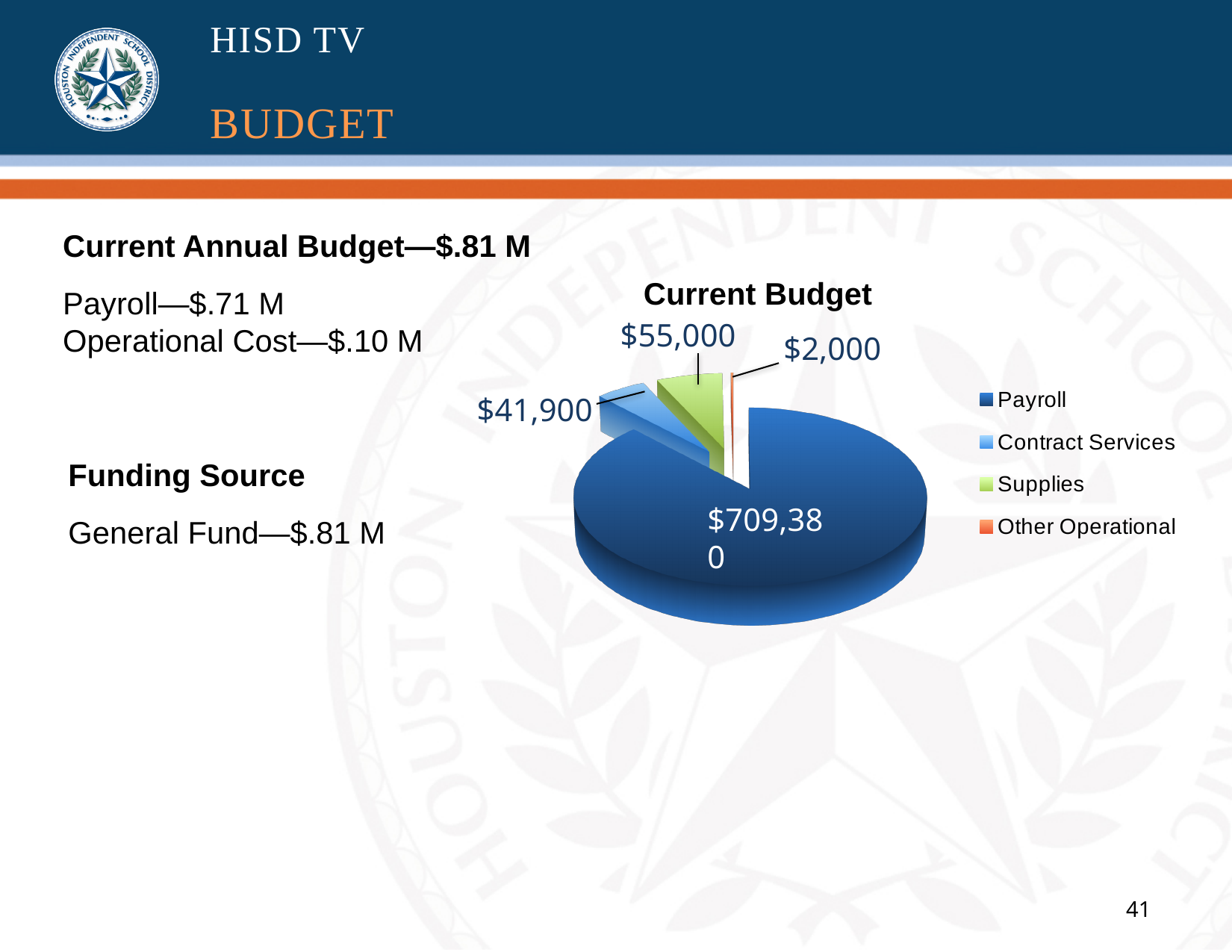
What is the value of the Contract Services slice in the Current Budget pie chart? $41,900 What is the title of the chart? Current Budget Which colour represents Supplies in the Current Budget pie chart? Green What is the value of the Other Operational slice in the Current Budget pie chart? $2,000 Which category has the largest slice in the Current Budget pie chart? Payroll What is the value of the Supplies slice in the Current Budget pie chart? $55,000 What is the value of the Payroll slice in the Current Budget pie chart? $709,380 What type of chart is shown on the slide? Pie chart Which category has the smallest slice in the Current Budget pie chart? Other Operational What is the difference between the Supplies and Contract Services values in the Current Budget pie chart? $13,100 Which is larger in the Current Budget pie chart, Supplies or Contract Services? Supplies How many categories does the legend of the Current Budget pie chart list? 4